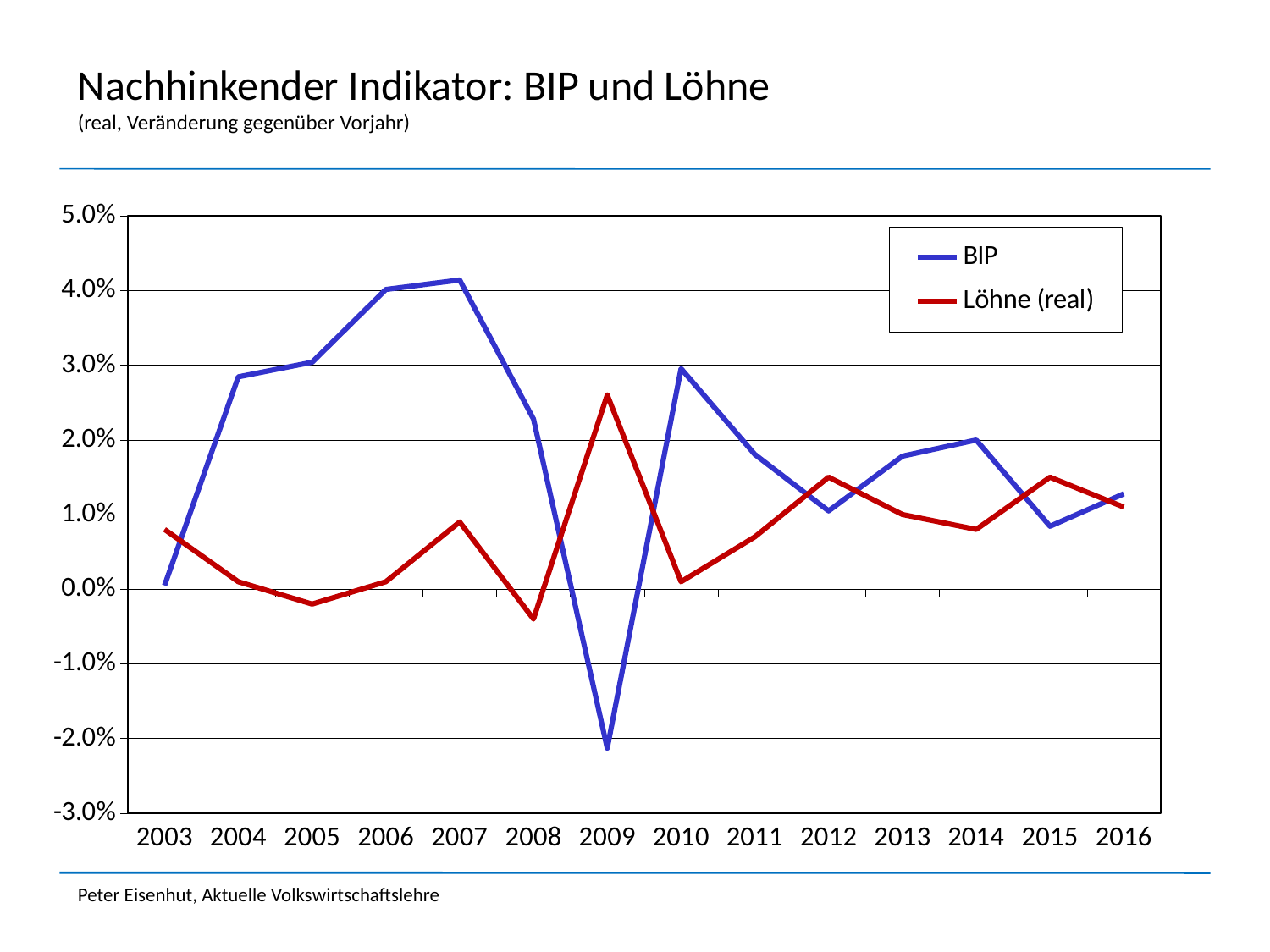
Does the BIP series rise or fall from 2003 to 2007? rise Is the BIP value for 2009 greater or less than -1.0%? less In which year is the BIP series at its lowest? 2009 Is the Löhne (real) value for 2009 greater or less than 2.0%? greater In which year is the Löhne (real) series at its highest? 2009 How many years are plotted along the x axis? 14 How many series does the legend list? 2 What colour is the BIP line in the chart? blue What kind of chart is shown on the slide? line chart Is the BIP value for 2006 greater or less than 3.0%? greater In 2015, which series has the larger value, BIP or Löhne (real)? Löhne (real) In 2007, which series has the larger value, BIP or Löhne (real)? BIP